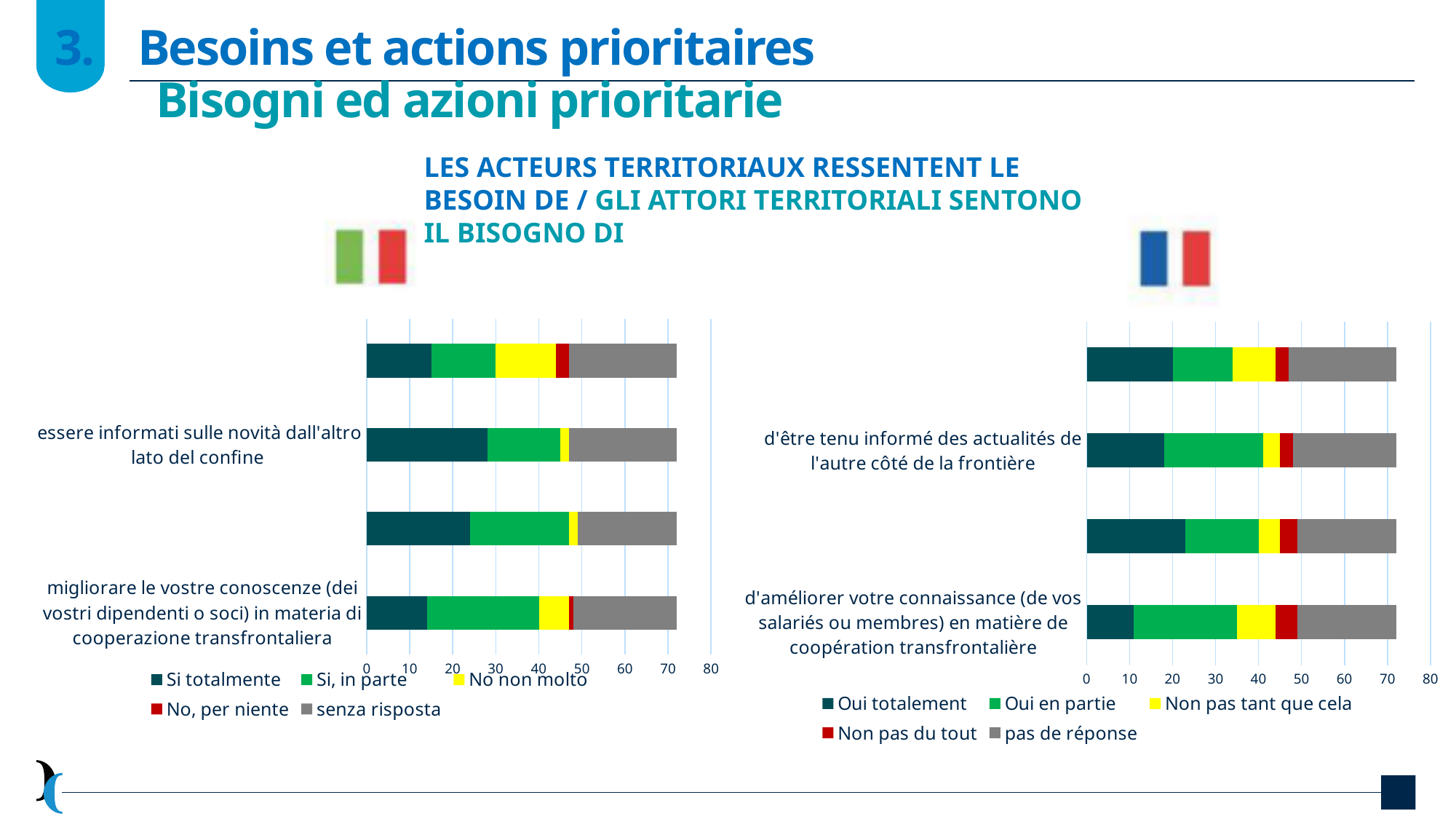
In the left chart, which colour represents the 'senza risposta' series? grey What kind of chart is the left chart on the slide? stacked bar chart In the left chart, is the 'Si totalmente' value for 'essere informati sulle novità dall'altro lato del confine' greater or less than 20? greater How many series does the legend of the right chart list? 5 In the left chart, is the 'Si totalmente' value for 'migliorare le vostre conoscenze (dei vostri dipendenti o soci) in materia di cooperazione transfrontaliera' greater or less than 20? less What is the last legend entry of the right chart? pas de réponse In the right chart, is the 'Oui totalement' value for 'd'améliorer votre connaissance (de vos salariés ou membres) en matière de coopération transfrontalière' greater or less than 20? less How many bars are plotted in the right chart? 4 How many series does the legend of the left chart list? 5 In the right chart, which category has the larger 'Oui totalement' value: 'd'être tenu informé des actualités de l'autre côté de la frontière' or 'd'améliorer votre connaissance (de vos salariés ou membres) en matière de coopération transfrontalière'? d'être tenu informé des actualités de l'autre côté de la frontière In the left chart, which category has the larger 'Si totalmente' value: 'essere informati sulle novità dall'altro lato del confine' or 'migliorare le vostre conoscenze (dei vostri dipendenti o soci) in materia di cooperazione transfrontaliera'? essere informati sulle novità dall'altro lato del confine